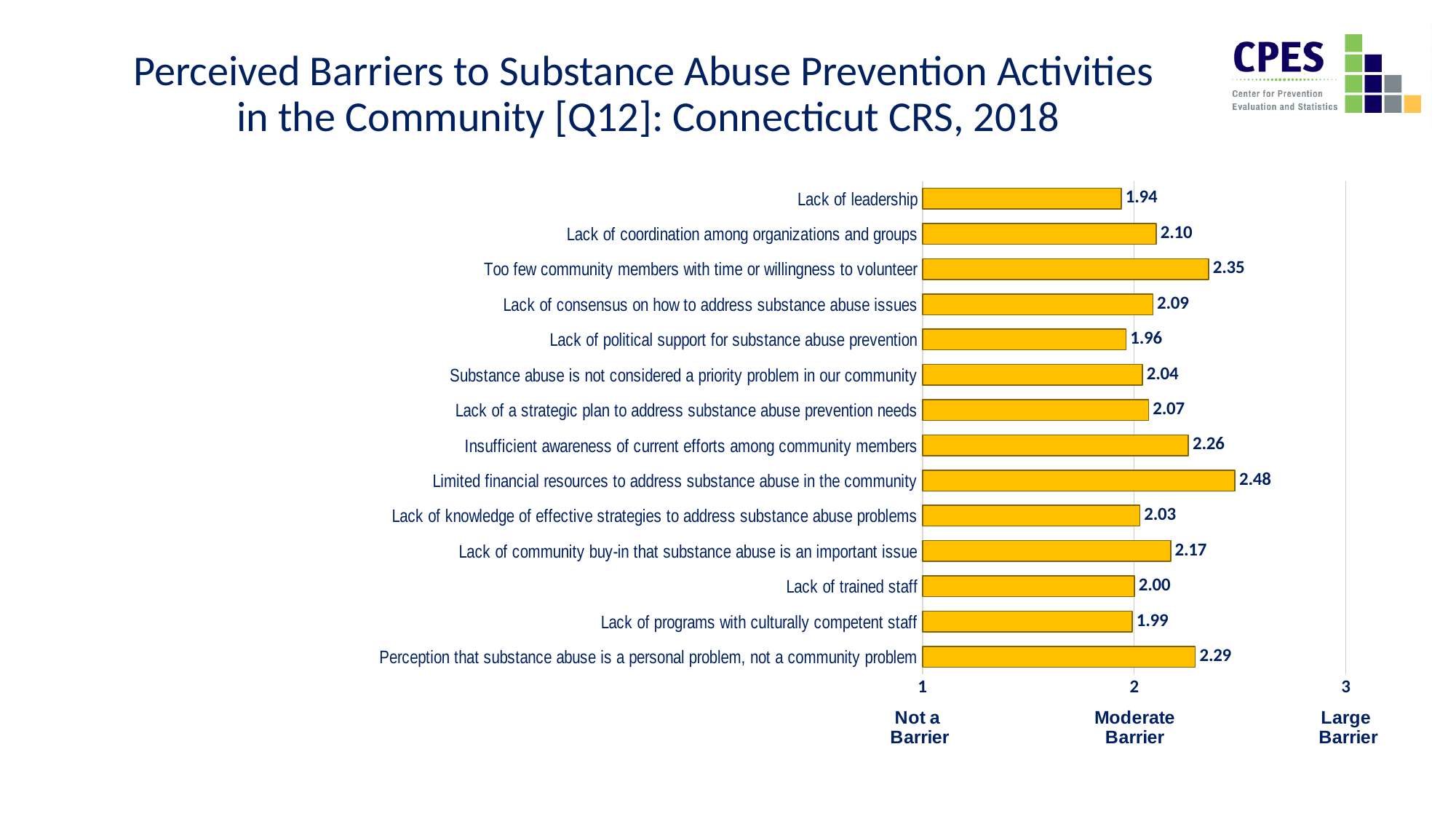
What is the value for 'Lack of leadership'? 1.94 What is the value for 'Lack of programs with culturally competent staff'? 1.99 What kind of chart is shown on the slide? bar chart What is the difference between the values for 'Too few community members with time or willingness to volunteer' and 'Lack of political support for substance abuse prevention'? 0.39 What is the value for 'Limited financial resources to address substance abuse in the community'? 2.48 What label is shown under the axis value 3? Large Barrier Which barrier has the highest value? Limited financial resources to address substance abuse in the community What is the value for 'Lack of trained staff'? 2.00 How many barriers are plotted in the chart? 14 Is the value for 'Perception that substance abuse is a personal problem, not a community problem' greater or less than 2? greater Which barrier has the lowest value? Lack of leadership Which is larger: the value for 'Insufficient awareness of current efforts among community members' or the value for 'Lack of community buy-in that substance abuse is an important issue'? Insufficient awareness of current efforts among community members